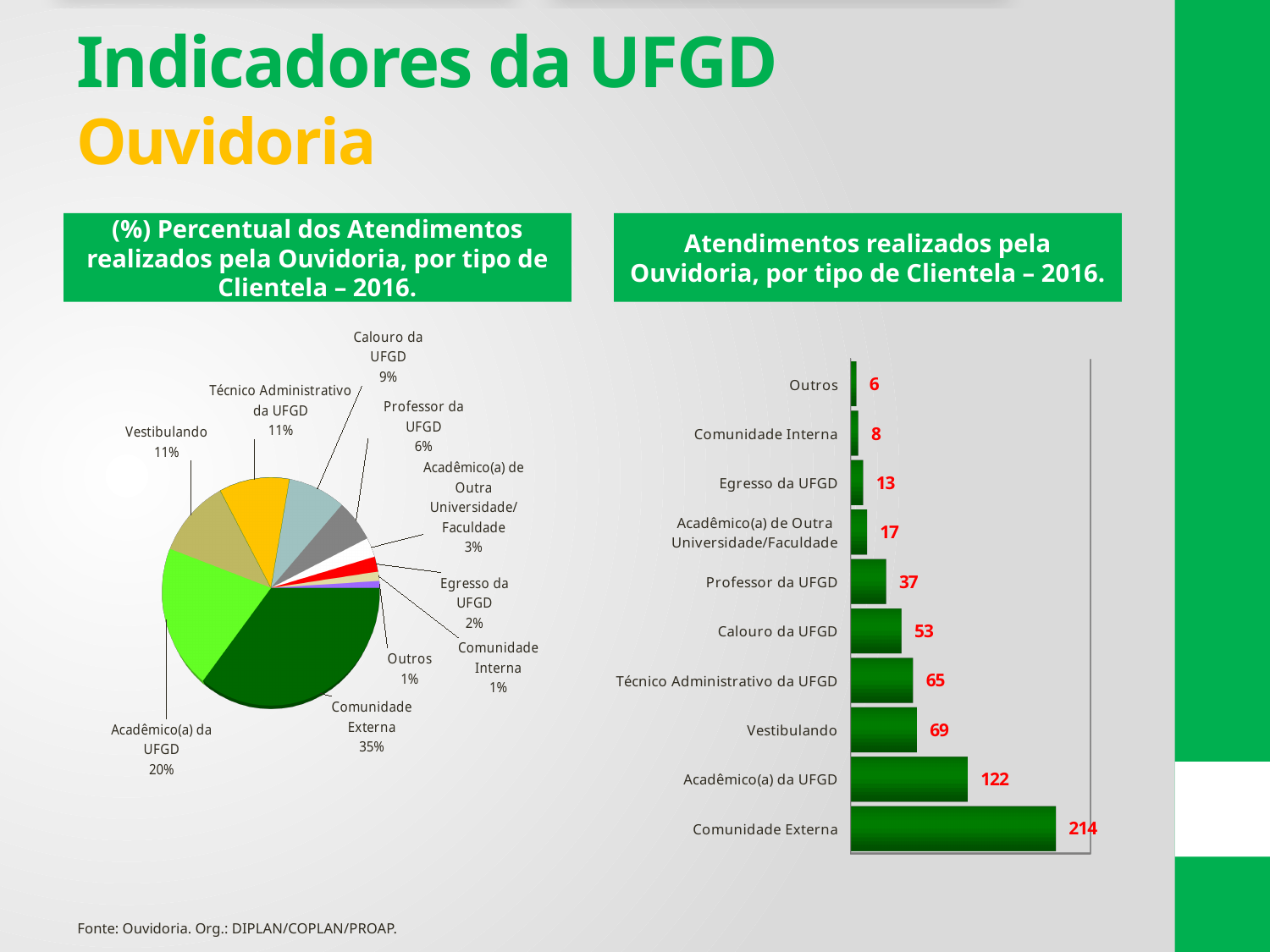
What type of chart is the chart on the left? Pie chart In the bar chart on the right, what is the value for Professor da UFGD? 37 In the bar chart on the right, which category has the highest value? Comunidade Externa In the pie chart on the left, what share does Comunidade Externa have? 35% In the bar chart on the right, which is larger: Calouro da UFGD or Técnico Administrativo da UFGD? Técnico Administrativo da UFGD In the pie chart on the left, what percentage is shown for Egresso da UFGD? 2% How many categories are shown in the bar chart on the right? 10 In the bar chart on the right, what is the value for Comunidade Externa? 214 What type of chart is the chart on the right? Bar chart In the bar chart on the right, what is the difference between Acadêmico(a) da UFGD and Vestibulando? 53 In the bar chart on the right, which category has the lowest value? Outros In the pie chart on the left, what percentage is shown for Acadêmico(a) da UFGD? 20%